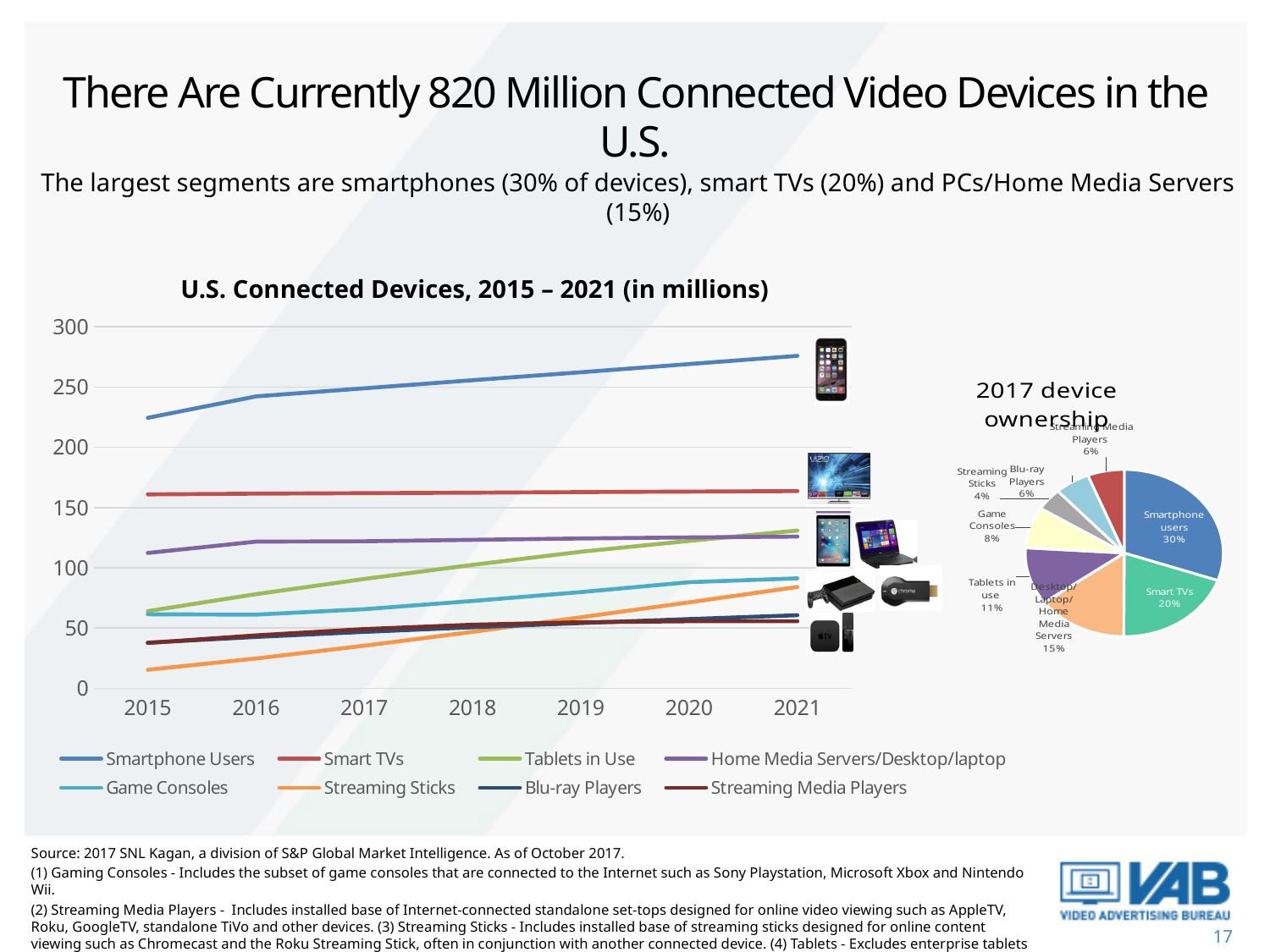
How many series does the legend of the 'U.S. Connected Devices, 2015 – 2021' line chart list? 8 In the 'U.S. Connected Devices, 2015 – 2021' line chart, do the values for Streaming Sticks rise or fall from 2015 to 2021? Rise In the '2017 device ownership' pie chart, what share do Smart TVs have? 20% In the 'U.S. Connected Devices, 2015 – 2021' line chart, is the value for Smartphone Users in 2015 greater or less than 200? greater In the 'U.S. Connected Devices, 2015 – 2021' line chart, which series has the highest value in 2021? Smartphone Users In the '2017 device ownership' pie chart, how many percentage points larger is the Smartphone users share than the Smart TVs share? 10 percentage points In the 'U.S. Connected Devices, 2015 – 2021' line chart, which series has the lowest value in 2015? Streaming Sticks How many years are shown on the x axis of the 'U.S. Connected Devices, 2015 – 2021' line chart? 7 In the '2017 device ownership' pie chart, which slice is the smallest? Streaming Sticks What kind of chart is 'U.S. Connected Devices, 2015 – 2021 (in millions)'? Line chart In the '2017 device ownership' pie chart, what share do Smartphone users have? 30% In the 'U.S. Connected Devices, 2015 – 2021' line chart, is the value for Smart TVs in 2021 greater or less than 150? greater